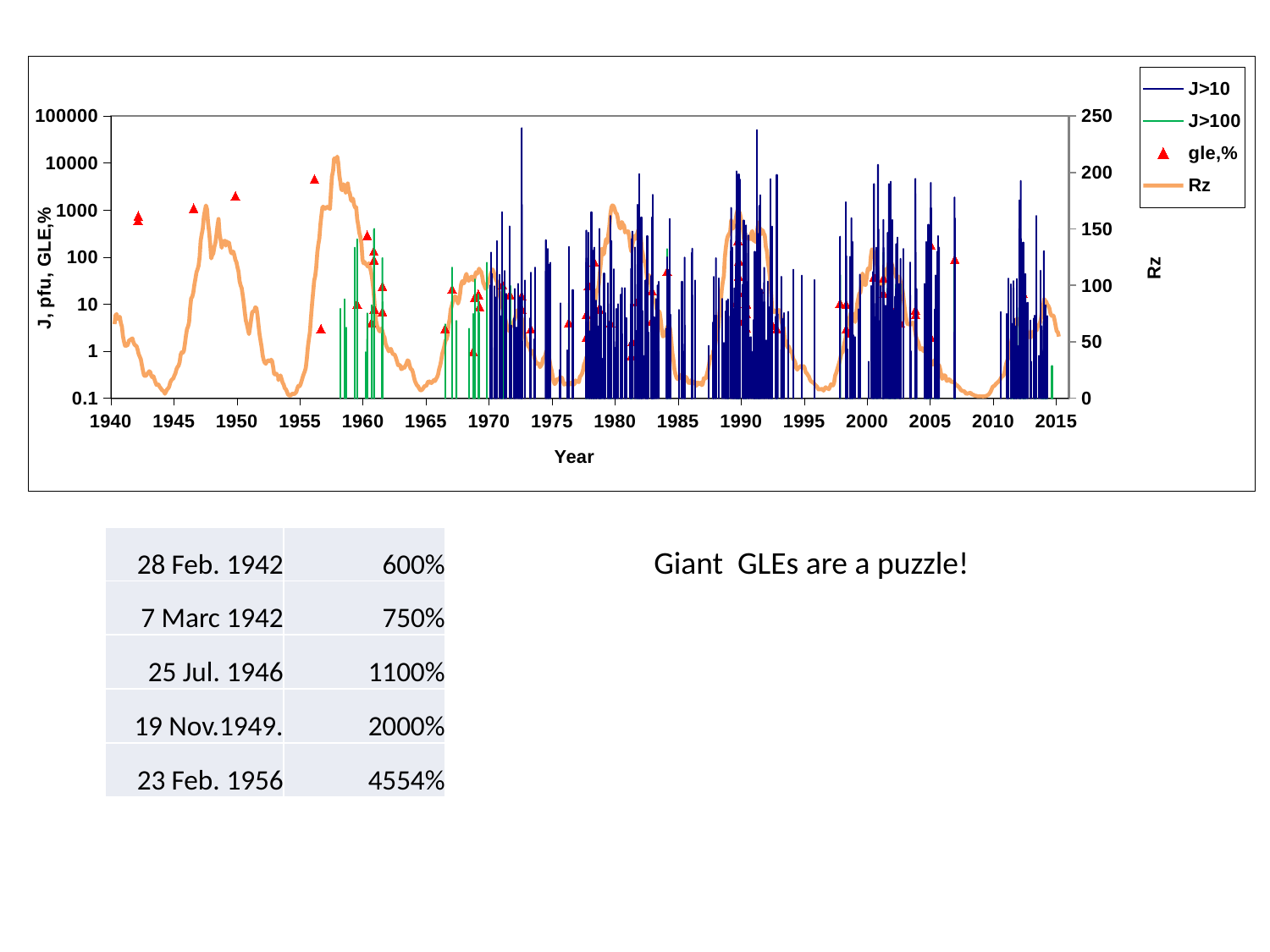
What is the label of the right-hand y axis of the chart? Rz Is the peak of the Rz line around 1990 greater or less than 200 on the right axis? less Is the gle,% marker plotted near 1956 greater or less than 1000 on the left axis? greater What are the four entries in the chart legend? J>10, J>100, gle,%, Rz What is the difference between the GLE values for 23 Feb. 1956 and 19 Nov. 1949 in the table? 2554% What is the highest value shown on the right (Rz) axis of the chart? 250 How many series does the chart legend list? 4 Which date in the table on the slide has the highest GLE value? 23 Feb. 1956 According to the table on the slide, what is the GLE value for 23 Feb. 1956? 4554% What is the label of the chart's x axis? Year Is the peak of the Rz line around 1958 greater or less than 200 on the right axis? greater What is the highest value shown on the left y axis of the chart? 100000